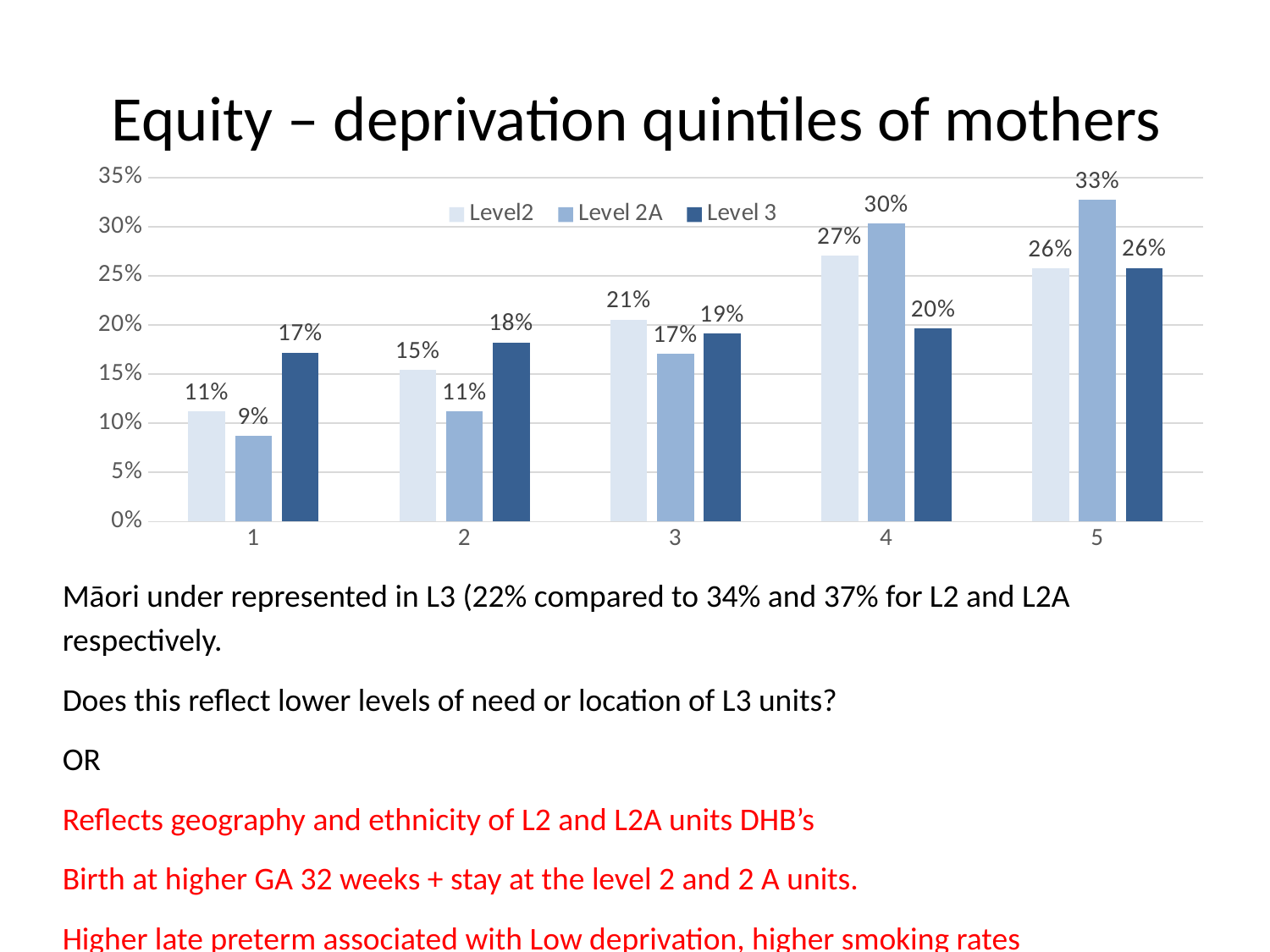
What is the difference between the Level 2A and Level 3 values at quintile 4? 10% What is the value for Level2 at quintile 3? 21% Is the value for Level 2A at quintile 5 greater or less than 30%? greater How many series does the legend list? 3 What is the value for Level 3 at quintile 4? 20% What is the value for Level 2A at quintile 1? 9% Which quintile has the lowest value for Level 3? 1 At quintile 2, which is larger: Level2 or Level 2A? Level2 What kind of chart is shown on the slide? bar chart How many quintile categories are shown on the x axis? 5 Do the Level 2A values rise or fall from quintile 2 to quintile 5? rise Which quintile has the highest value for Level 2A? 5